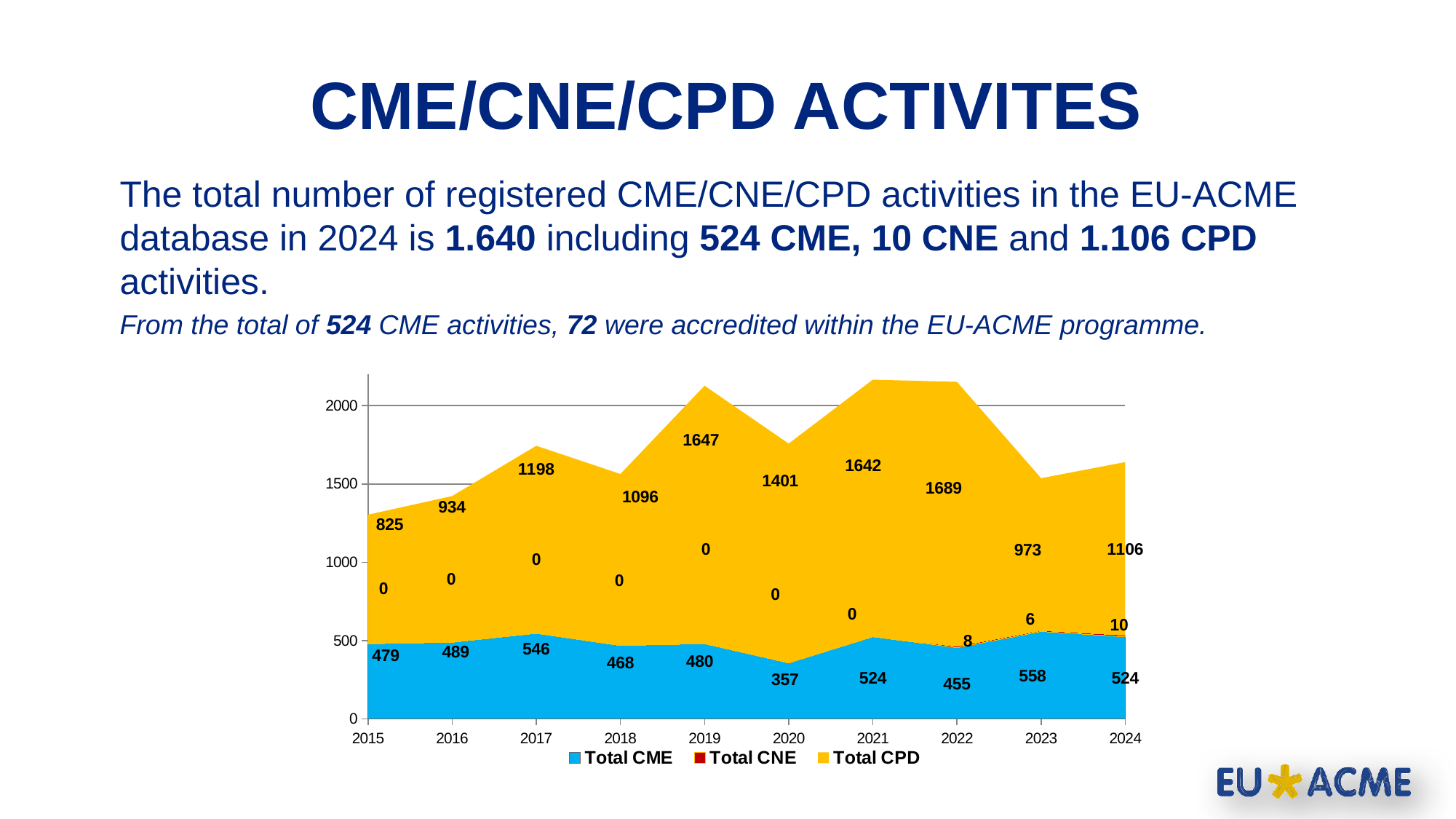
What is the combined total of Total CME, Total CNE and Total CPD in 2024? 1640 Which year has the larger Total CPD value, 2017 or 2018? 2017 How many years are shown on the x axis? 10 What is the value of Total CPD in 2019? 1647 What is the value of Total CNE in 2022? 8 Does Total CPD rise or fall from 2015 to 2017? Rise What kind of chart is shown on the slide? Stacked area chart In which year is Total CPD highest? 2022 In which year is Total CME lowest? 2020 How many series does the legend list? 3 What is the difference between Total CME in 2023 and Total CME in 2022? 103 What is the value of Total CME in 2020? 357